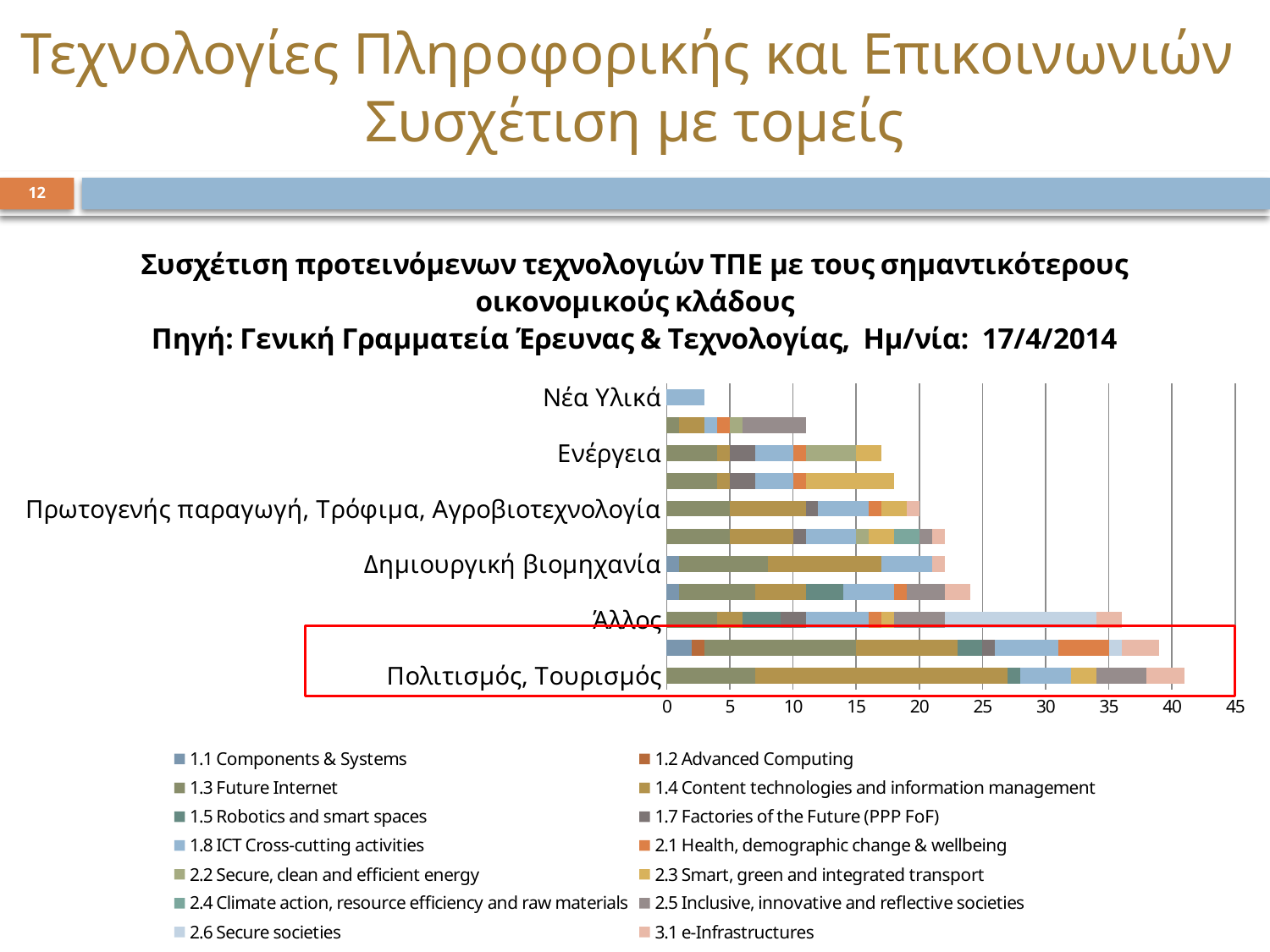
Which has the longer total bar, Ενέργεια or Νέα Υλικά? Ενέργεια What kind of chart is shown on the slide? Stacked bar chart Which labelled category has the longest total bar? Πολιτισμός, Τουρισμός How many category labels are shown on the vertical axis of the chart? 6 Is the total bar length for Δημιουργική βιομηχανία greater or less than 20? greater Is the total bar length for Πολιτισμός, Τουρισμός greater or less than 40? greater Is the total bar length for Νέα Υλικά greater or less than 5? less How many series does the legend list? 14 Which has the longer total bar, Πολιτισμός, Τουρισμός or Άλλος? Πολιτισμός, Τουρισμός What is the maximum value shown on the horizontal axis of the chart? 45 Which labelled category has the shortest total bar? Νέα Υλικά